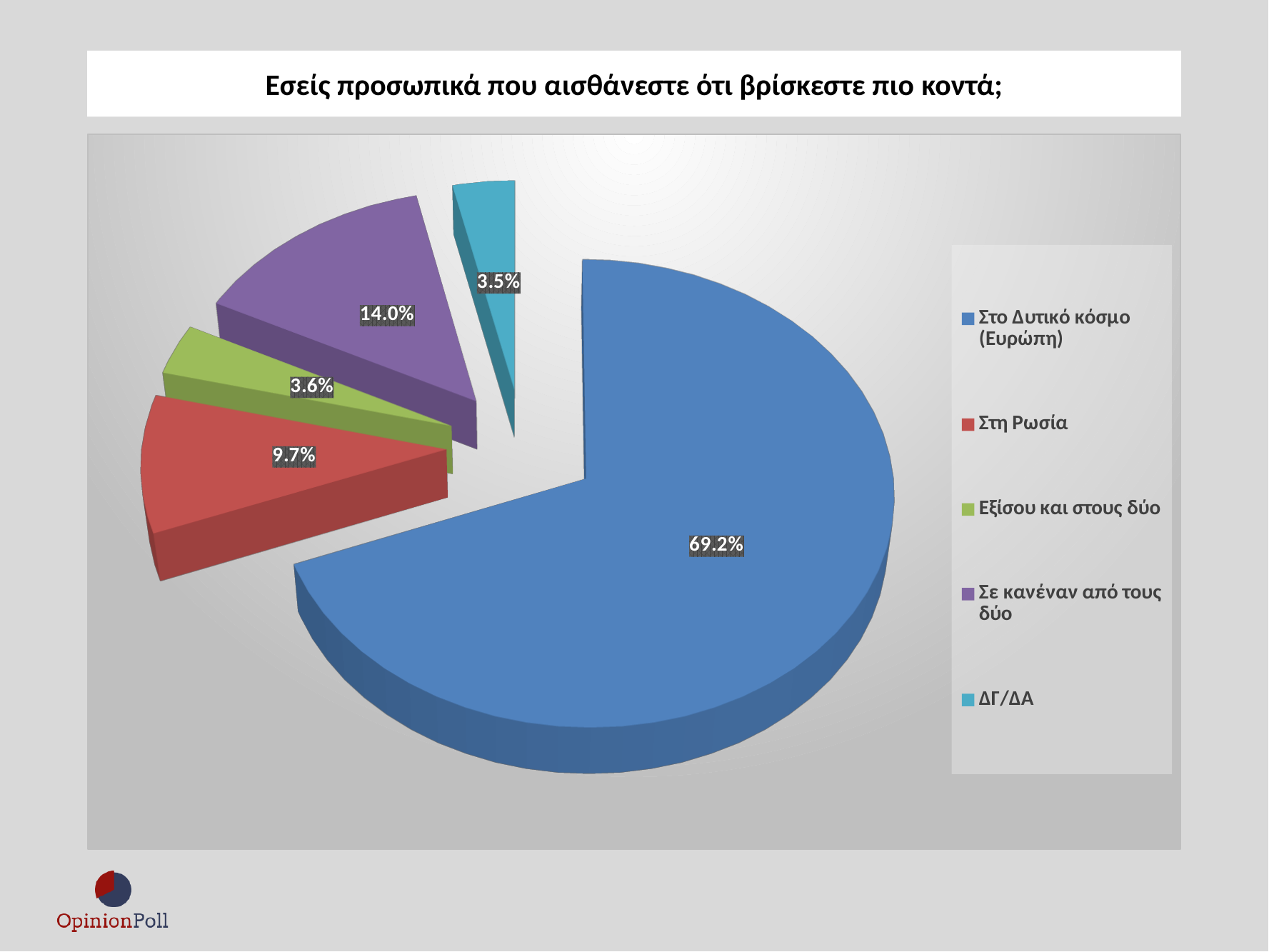
What percentage of respondents answered "Εξίσου και στους δύο"? 3.6% What percentage of respondents answered "Σε κανέναν από τους δύο"? 14.0% What is the title of the chart? Εσείς προσωπικά που αισθάνεστε ότι βρίσκεστε πιο κοντά; Which is larger: the share for "Στη Ρωσία" or the share for "Σε κανέναν από τους δύο"? Σε κανέναν από τους δύο Which category has the smallest share of the pie? ΔΓ/ΔΑ What percentage of respondents answered "Στο Δυτικό κόσμο (Ευρώπη)"? 69.2% What percentage of respondents answered "Στη Ρωσία"? 9.7% How many categories does the legend list? 5 What is the difference in percentage points between "Σε κανέναν από τους δύο" and "Στη Ρωσία"? 4.3 What percentage of respondents answered "ΔΓ/ΔΑ"? 3.5% What type of chart is shown on the slide? pie chart Which category has the largest share of the pie? Στο Δυτικό κόσμο (Ευρώπη)